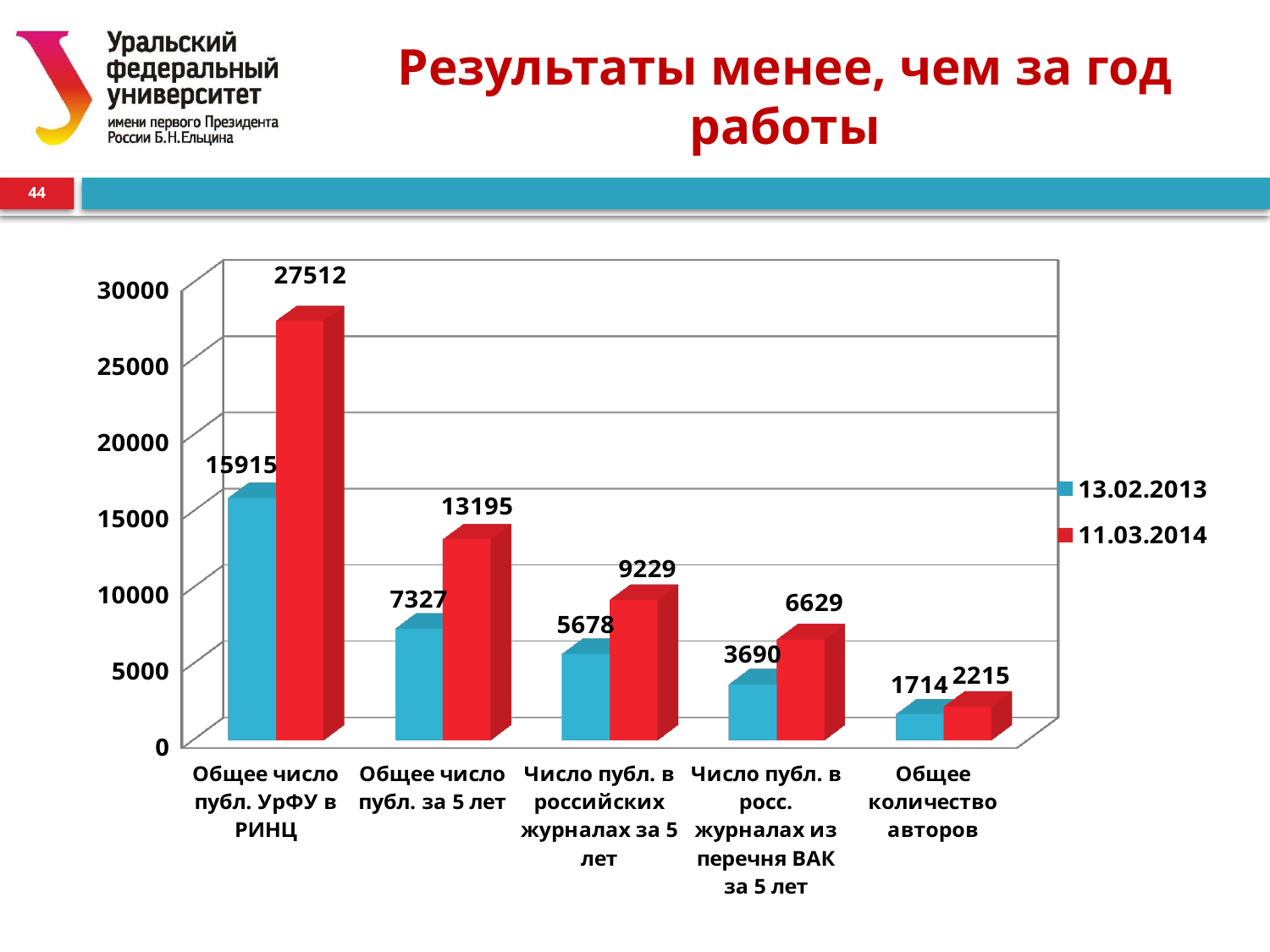
How many series does the legend list? 2 What is the difference between the 11.03.2014 and 13.02.2013 values for 'Общее число публ. за 5 лет'? 5868 What is the value for 'Общее количество авторов' in the 13.02.2013 series? 1714 Is the 13.02.2013 value for 'Число публ. в российских журналах за 5 лет' greater or less than 10000? less What is the difference between the 11.03.2014 and 13.02.2013 values for 'Число публ. в росс. журналах из перечня ВАК за 5 лет'? 2939 Which category has the highest value in the 13.02.2013 series? Общее число публ. УрФУ в РИНЦ Which category has the lowest value in the 11.03.2014 series? Общее количество авторов What kind of chart is shown on the slide? bar chart Which is larger: the 13.02.2013 value for 'Общее число публ. за 5 лет' or the 11.03.2014 value for 'Число публ. в росс. журналах из перечня ВАК за 5 лет'? Общее число публ. за 5 лет (13.02.2013) What is the value for 'Число публ. в российских журналах за 5 лет' in the 11.03.2014 series? 9229 What is the value for 'Общее число публ. УрФУ в РИНЦ' in the 11.03.2014 series? 27512 How many categories are shown on the x axis? 5